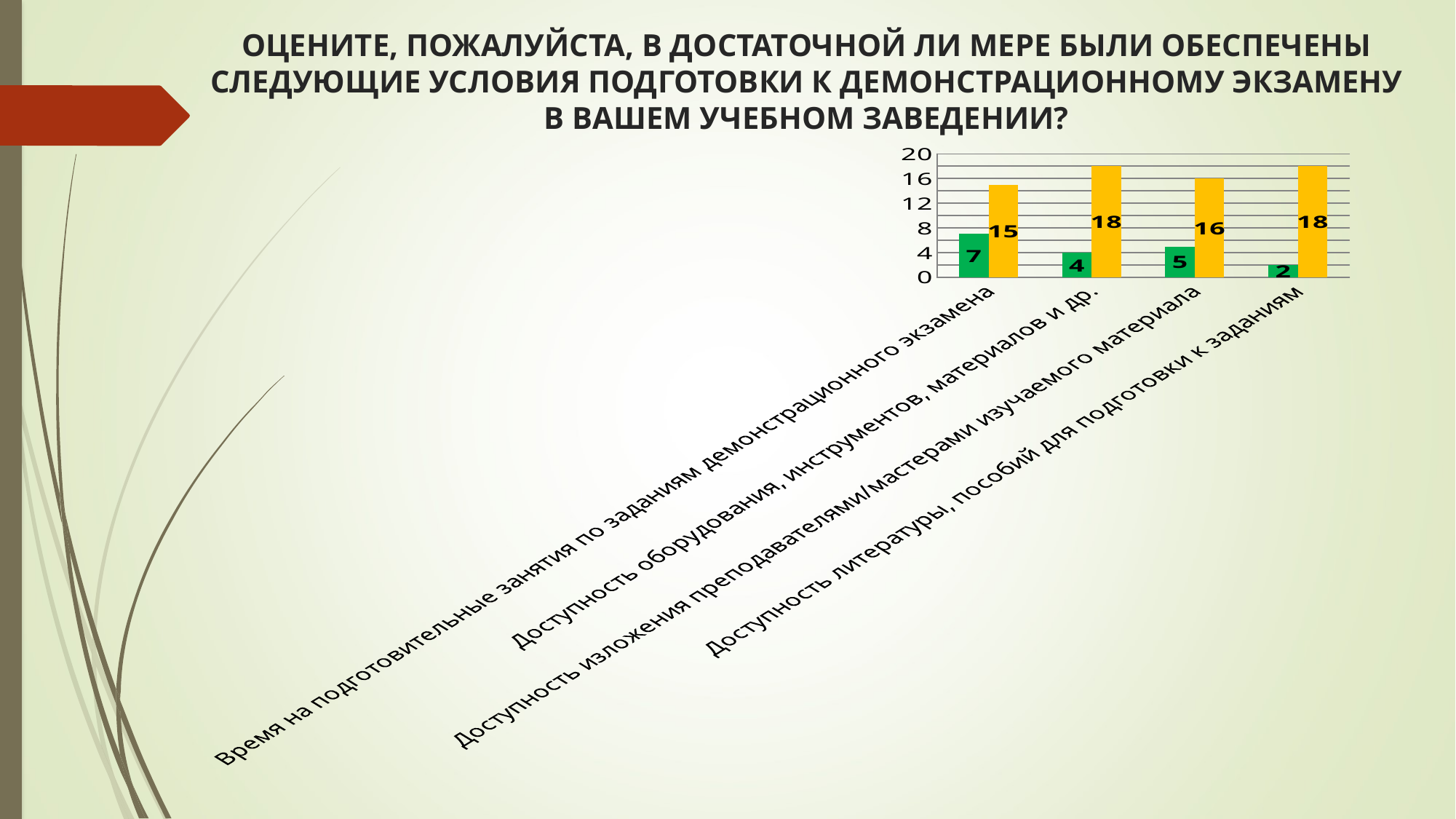
What is the difference between the yellow bar values for "Доступность оборудования, инструментов, материалов и др." and "Доступность изложения преподавателями/мастерами изучаемого материала"? 2 Which category has the highest green bar value? Время на подготовительные занятия по заданиям демонстрационного экзамена Which category has the lowest green bar value? Доступность литературы, пособий для подготовки к заданиям Is the yellow bar value for "Время на подготовительные занятия по заданиям демонстрационного экзамена" greater or less than 12? greater What is the value of the yellow bar for "Доступность литературы, пособий для подготовки к заданиям"? 18 What is the difference between the yellow and green bar values for "Доступность изложения преподавателями/мастерами изучаемого материала"? 11 What kind of chart is shown on the slide? bar chart What is the value of the green bar for "Время на подготовительные занятия по заданиям демонстрационного экзамена"? 7 Which is larger for "Время на подготовительные занятия по заданиям демонстрационного экзамена": the green bar or the yellow bar? the yellow bar How many categories are shown on the x axis of the chart? 4 What is the value of the yellow bar for "Доступность оборудования, инструментов, материалов и др."? 18 What is the value of the green bar for "Доступность изложения преподавателями/мастерами изучаемого материала"? 5